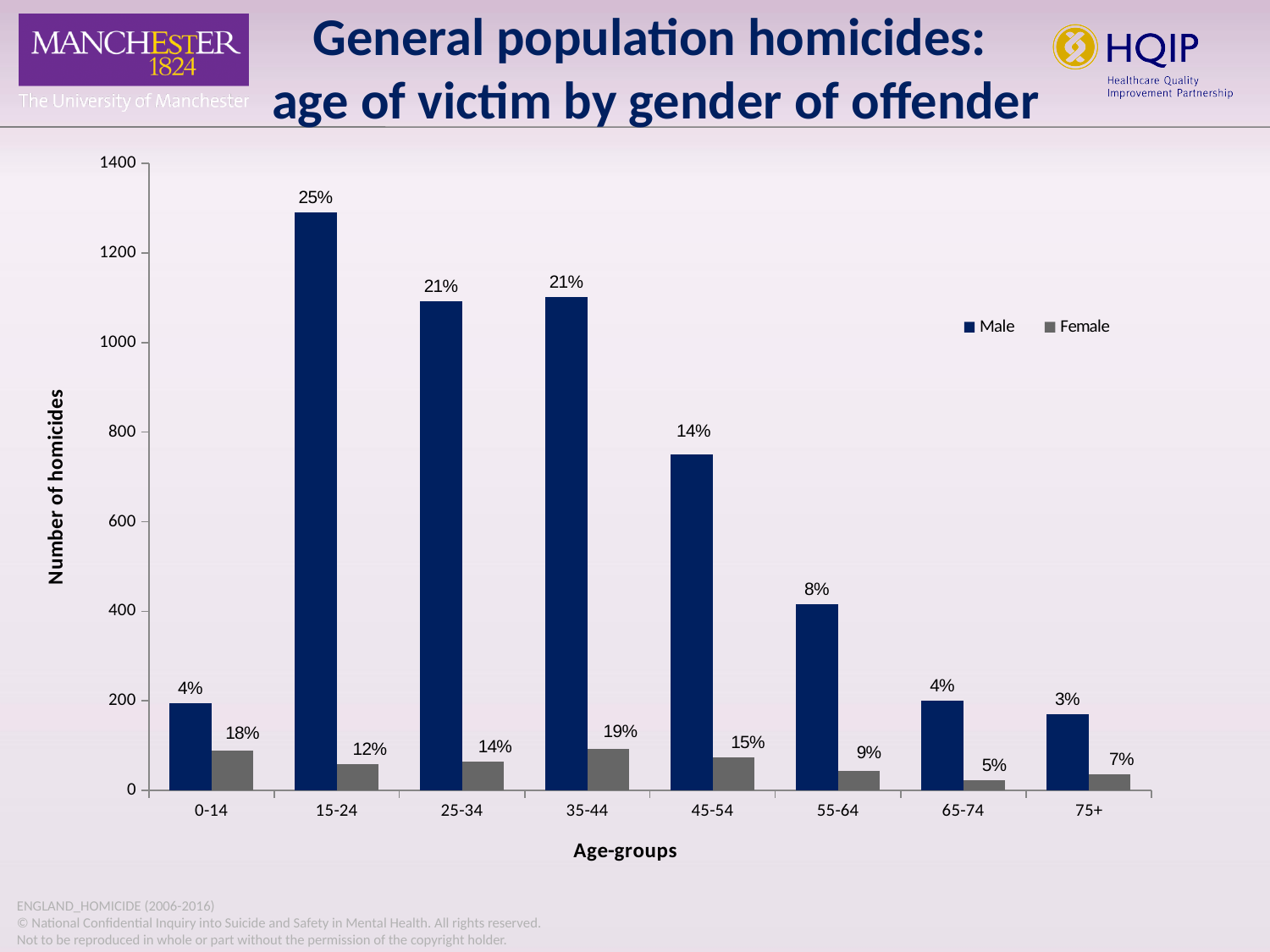
In the 0-14 age-group, which bar is taller, Male or Female? Male How many age-groups are shown on the x axis? 8 Which age-group has the lowest Male bar? 75+ Is the number of homicides for Male in the 45-54 age-group greater or less than 600? greater What is the difference between the Male percentage labels for the 15-24 and 45-54 age-groups? 11 percentage points What percentage label is shown on the Female bar for the 0-14 age-group? 18% What type of chart is shown on the slide? Bar chart Which age-group has the highest Male bar? 15-24 Is the number of homicides for Male in the 25-34 age-group greater or less than 1000? greater What percentage label is shown on the Male bar for the 15-24 age-group? 25% How many series does the legend list? 2 What percentage label is shown on the Female bar for the 35-44 age-group? 19%